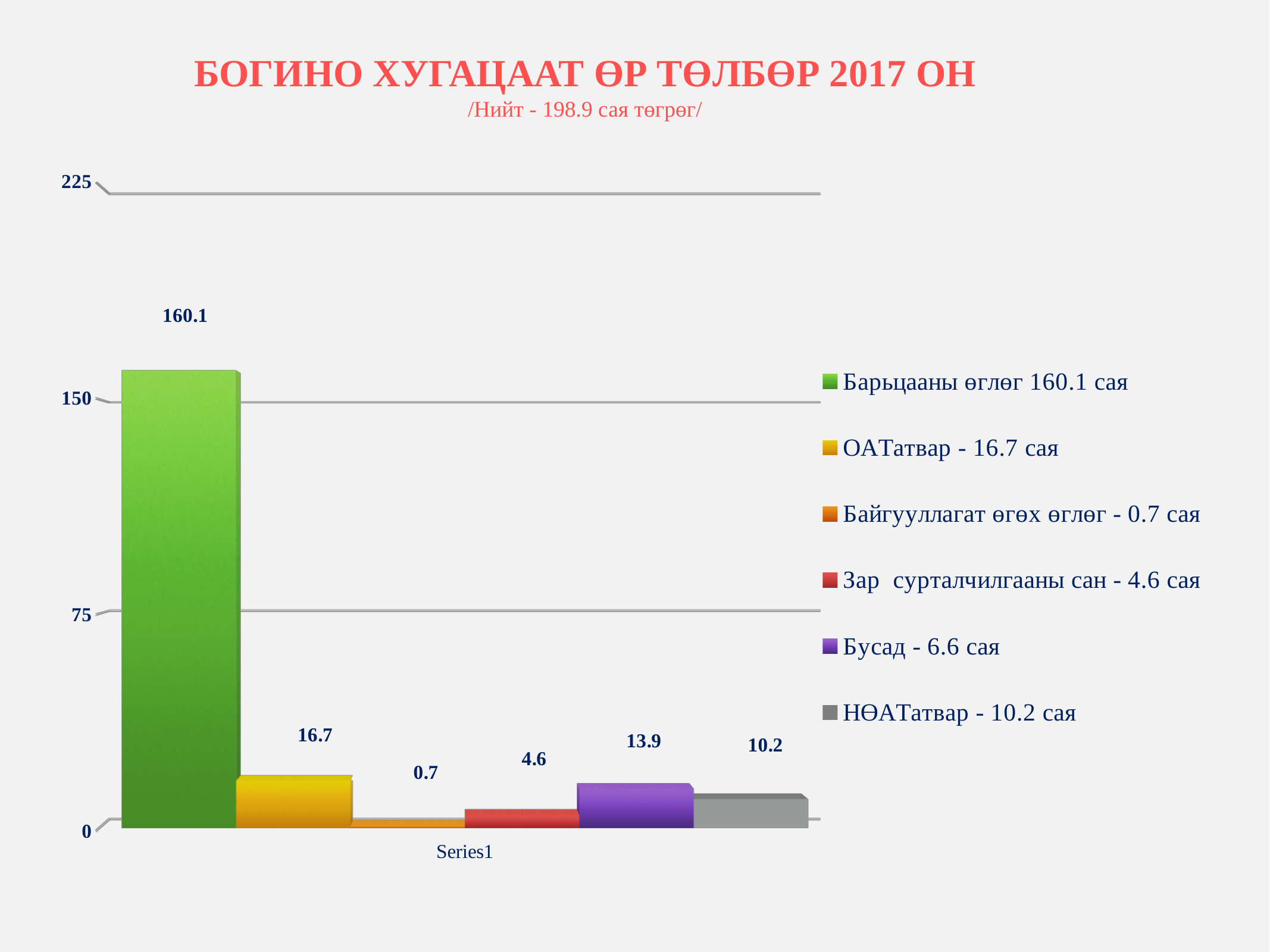
How many series does the legend list? 6 What is the difference between the values for Барьцааны өглөг and ОАТатвар? 143.4 What is the value shown for Барьцааны өглөг? 160.1 What kind of chart is shown on the slide? bar chart Which is larger, the value for ОАТатвар or the value for НӨАТатвар? ОАТатвар What is the value shown for Байгууллагат өгөх өглөг? 0.7 What is the value shown for НӨАТатвар? 10.2 What is the difference between the values for НӨАТатвар and Зар сурталчилгааны сан? 5.6 Which series has the highest value? Барьцааны өглөг Which series has the lowest value? Байгууллагат өгөх өглөг Is the value for Барьцааны өглөг greater or less than 150? greater What is the value shown for ОАТатвар? 16.7